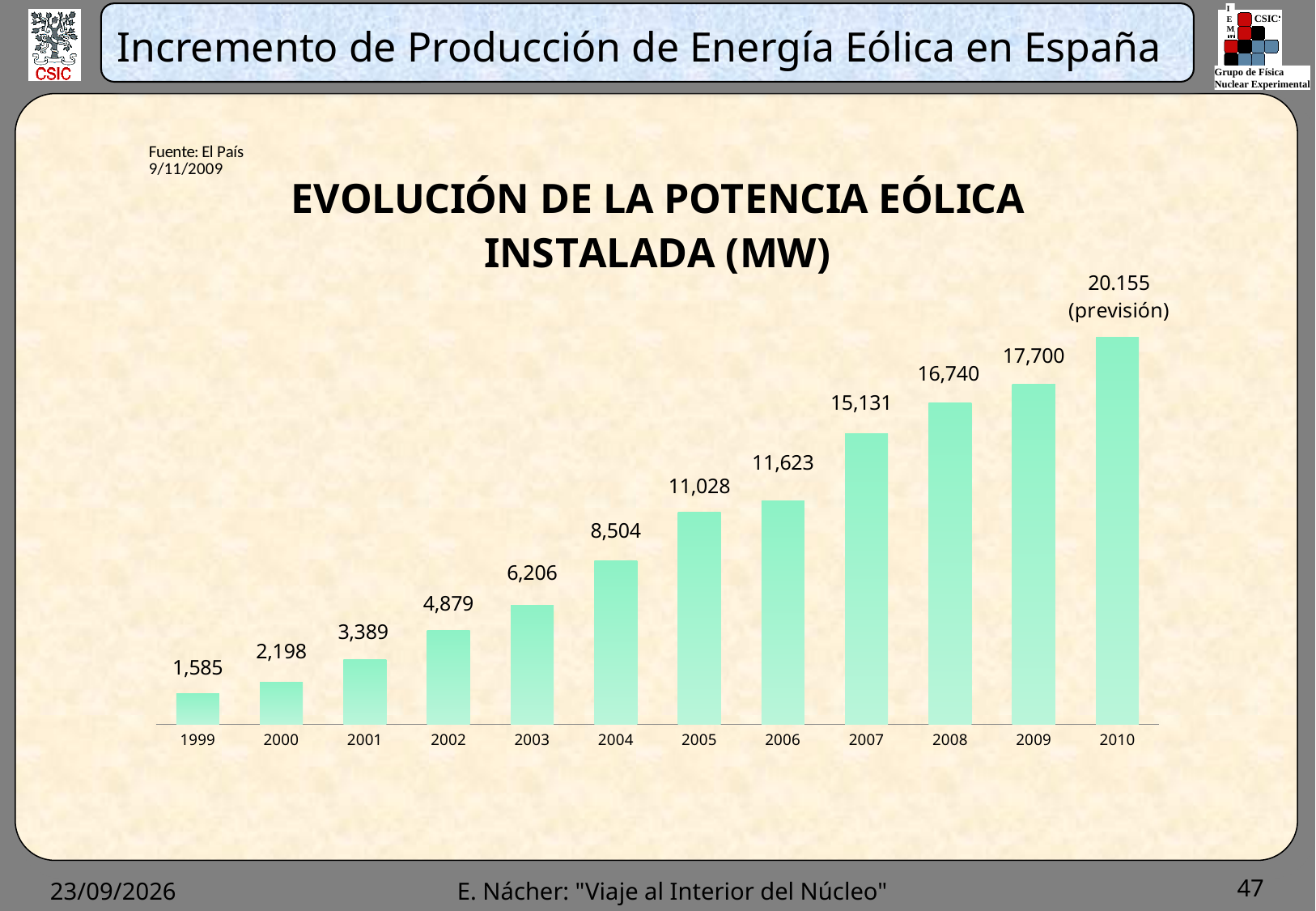
Which year has the highest value in the chart? 2010 What value is labelled for 2010? 20.155 (previsión) Do the values rise or fall from 1999 to 2010? Rise How many years are shown on the x axis? 12 What is the title of the chart? EVOLUCIÓN DE LA POTENCIA EÓLICA INSTALADA (MW) What kind of chart is shown on the slide? Bar chart Which year has the lowest installed wind power? 1999 What is the installed wind power value shown for 2005? 11,028 What is the difference between the values for 2004 and 2003? 2,298 Which is larger, the value for 2006 or the value for 2007? 2007 What is the difference between the values for 2009 and 2008? 960 What is the value shown for 1999? 1,585